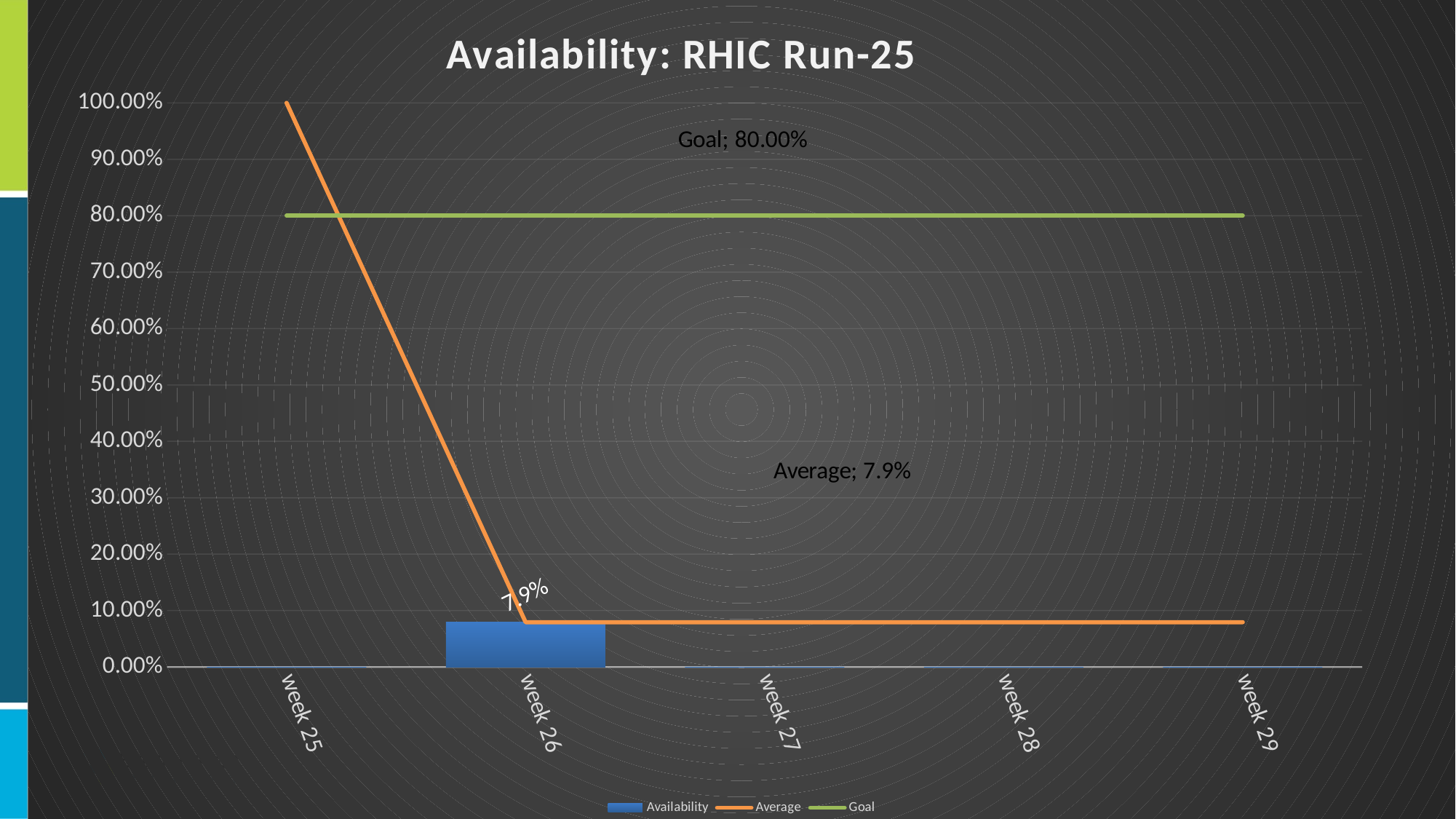
What kind of chart is this? Bar and line chart Is the Average line at week 25 greater or less than 90.00%? greater Which is larger, the Goal value or the Average value? Goal How many weeks are shown on the x axis? 5 What value is labelled for the Average line? 7.9% Does the Average line rise or fall from week 25 to week 26? fall Which week has the highest Availability bar? week 26 What value is labelled for the Goal line? 80.00% What is the Availability value shown for week 26? 7.9% What is the title of the chart? Availability: RHIC Run-25 What is the difference between the Goal value (80.00%) and the Average value (7.9%)? 72.1% How many series does the legend list? 3